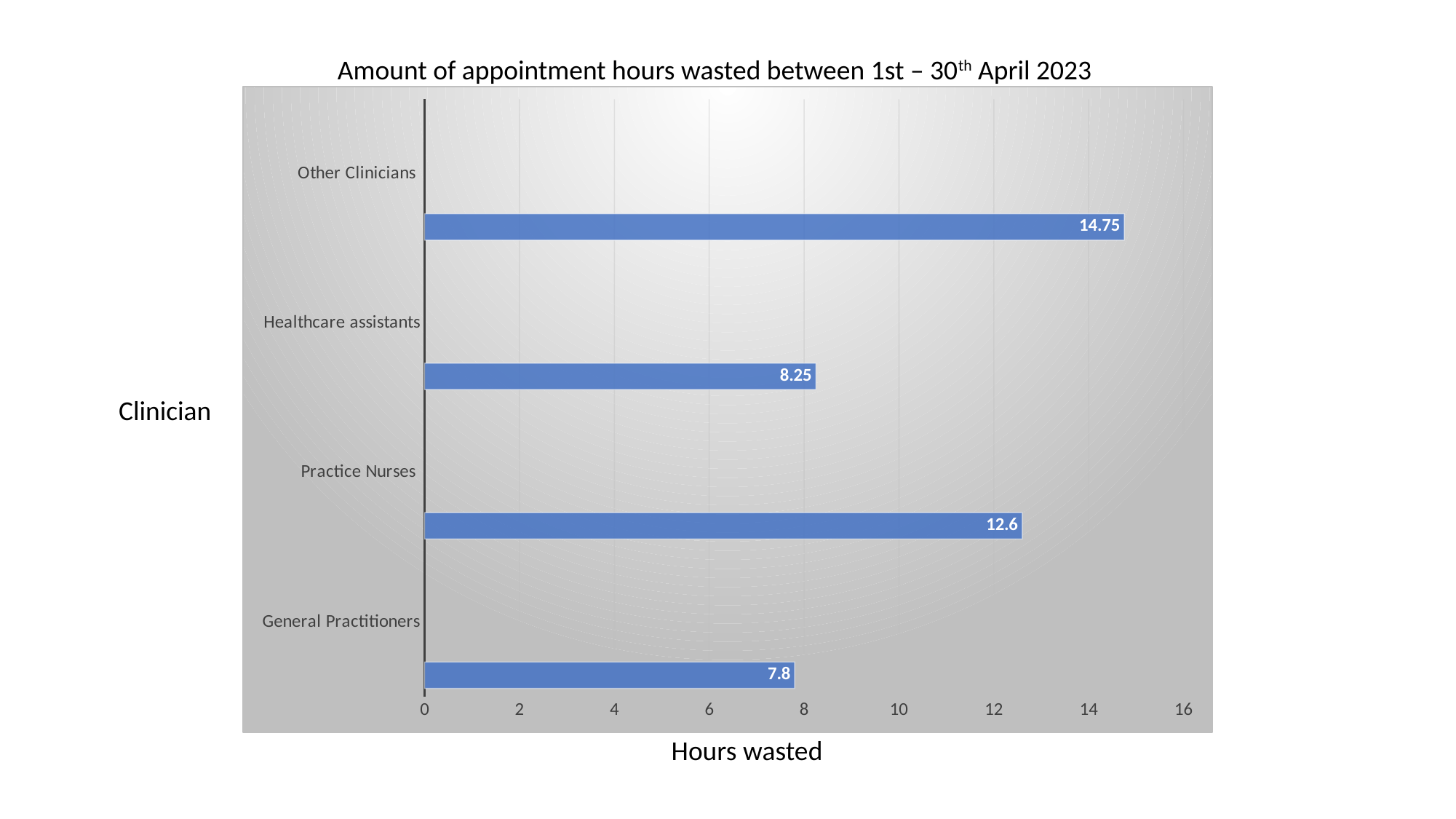
How many hours were wasted by Healthcare assistants? 8.25 What is the difference in hours wasted between Other Clinicians and General Practitioners? 6.95 Which group wasted more hours, Practice Nurses or Healthcare assistants? Practice Nurses Which clinician group has the lowest number of hours wasted? General Practitioners What is the title of the chart? Amount of appointment hours wasted between 1st – 30th April 2023 What is the label of the horizontal axis? Hours wasted Which clinician group has the highest number of hours wasted? Other Clinicians How many hours were wasted by Practice Nurses? 12.6 How many hours were wasted by Other Clinicians? 14.75 How many hours were wasted by General Practitioners? 7.8 How many clinician categories are shown in the chart? 4 What type of chart is shown on the slide? bar chart